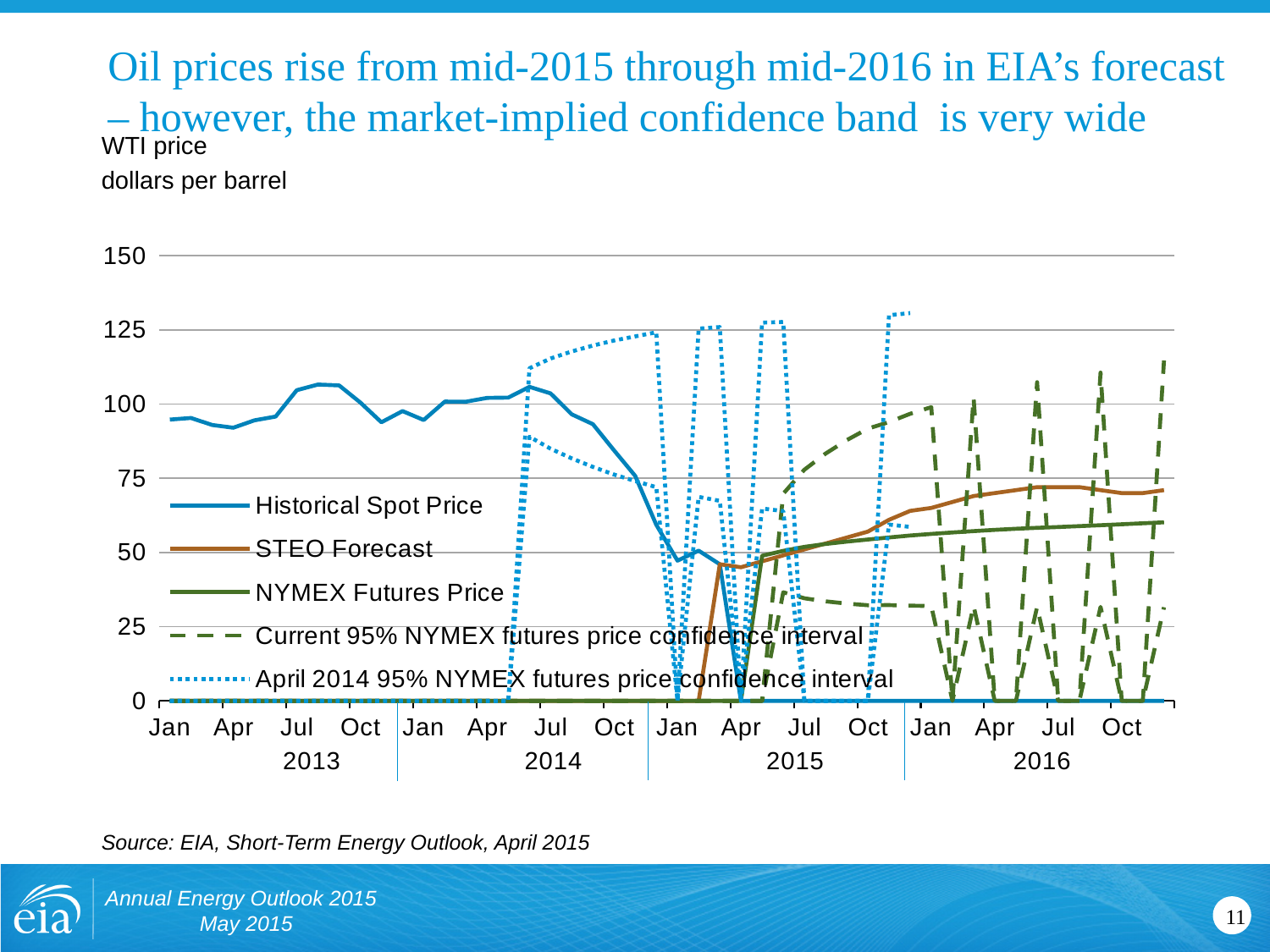
Does the Historical Spot Price rise or fall between Jul 2014 and Jan 2015? fall Is the NYMEX Futures Price in Oct 2016 greater or less than 75? less In Oct 2016, which is higher: the STEO Forecast or the NYMEX Futures Price? STEO Forecast Is the Historical Spot Price in Jul 2014 greater or less than 75? greater Which series is drawn as a dotted blue line? April 2014 95% NYMEX futures price confidence interval What kind of chart is shown on the slide? line chart Is the Historical Spot Price in Jan 2015 greater or less than 75? less How many series does the legend list? 5 Does the STEO Forecast rise or fall between Apr 2015 and Jul 2016? rise How many years are labeled on the x axis? 4 What unit is the WTI price measured in, according to the axis label? dollars per barrel